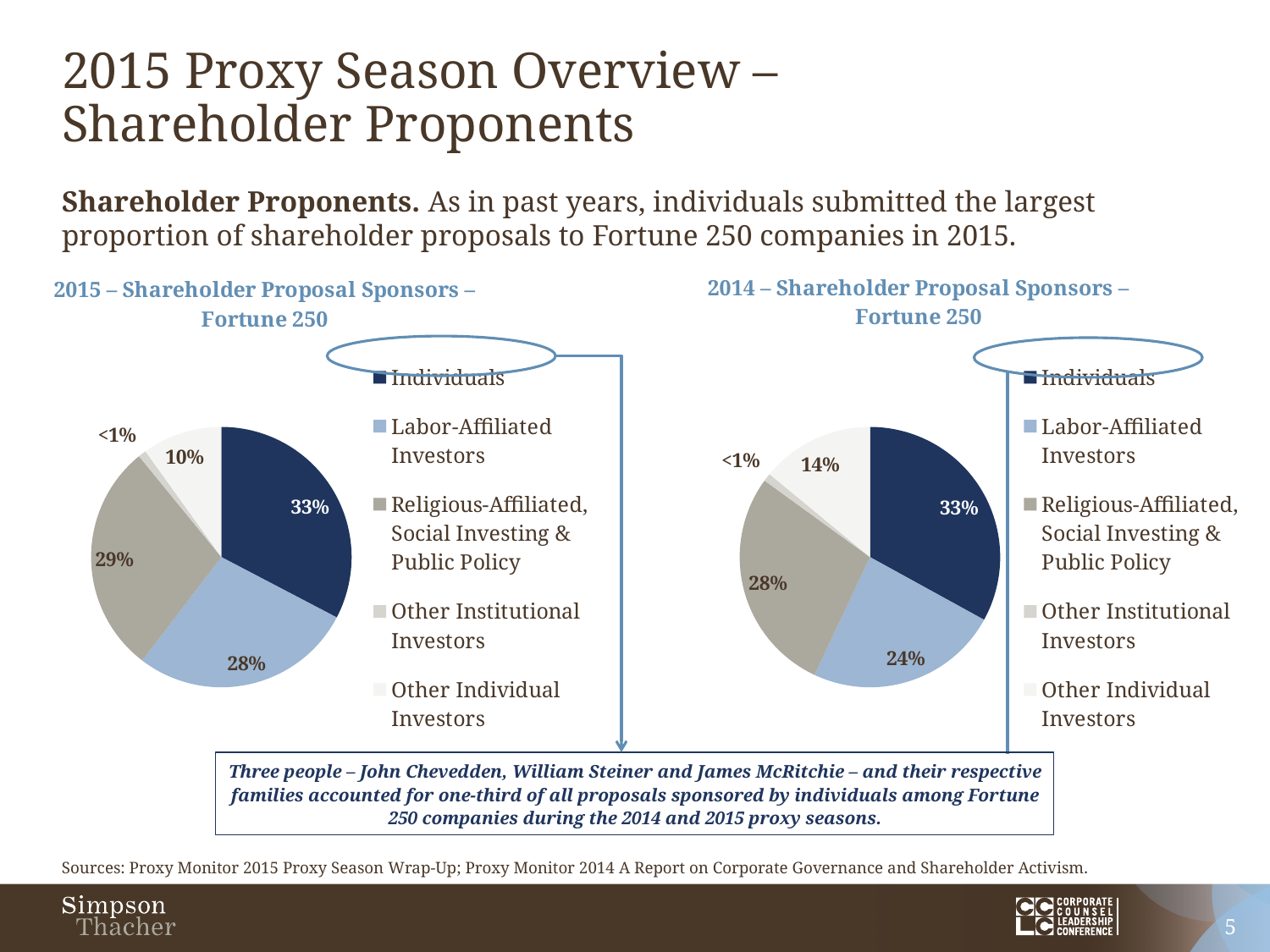
On the 2014 – Shareholder Proposal Sponsors – Fortune 250 chart, which category has the smallest share? Other Institutional Investors On the 2014 – Shareholder Proposal Sponsors – Fortune 250 chart, what is the difference between the Individuals share and the Labor-Affiliated Investors share? 9% On the 2015 – Shareholder Proposal Sponsors – Fortune 250 chart, which category has the largest share? Individuals On the 2015 – Shareholder Proposal Sponsors – Fortune 250 chart, what share is shown for Religious-Affiliated, Social Investing & Public Policy? 29% How many categories does the legend of the 2014 – Shareholder Proposal Sponsors – Fortune 250 chart list? 5 On the 2014 – Shareholder Proposal Sponsors – Fortune 250 chart, what share is shown for Other Institutional Investors? <1% What type of chart is used for the 2015 – Shareholder Proposal Sponsors – Fortune 250 chart? Pie chart On the 2014 – Shareholder Proposal Sponsors – Fortune 250 chart, what share is shown for Labor-Affiliated Investors? 24% On the 2015 – Shareholder Proposal Sponsors – Fortune 250 chart, what share is shown for Labor-Affiliated Investors? 28% On the 2015 – Shareholder Proposal Sponsors – Fortune 250 chart, what share of proposals was sponsored by Individuals? 33% On the 2014 – Shareholder Proposal Sponsors – Fortune 250 chart, what share is shown for Other Individual Investors? 14% On the 2015 – Shareholder Proposal Sponsors – Fortune 250 chart, which is larger: the share for Religious-Affiliated, Social Investing & Public Policy or the share for Labor-Affiliated Investors? Religious-Affiliated, Social Investing & Public Policy